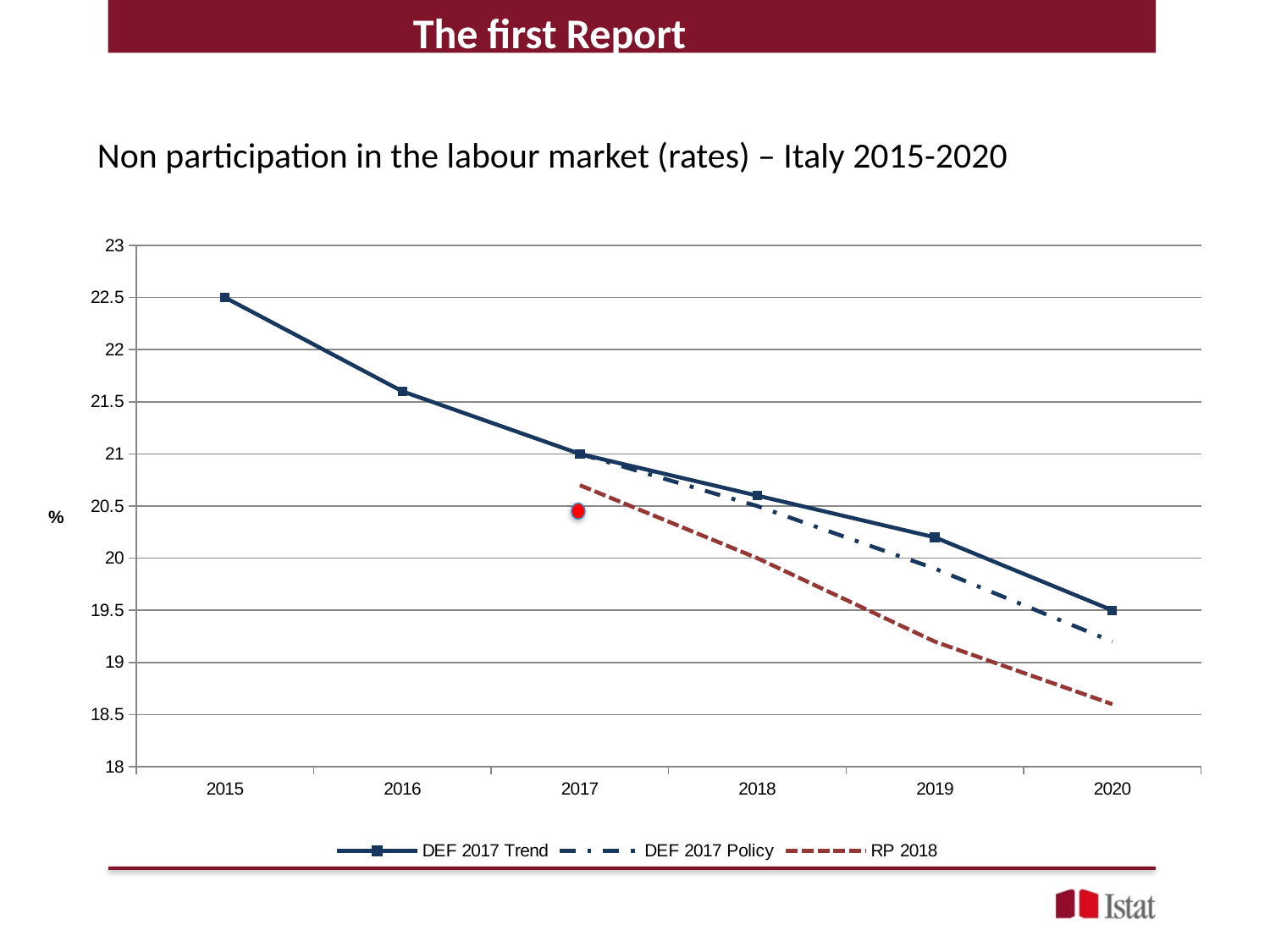
What is the difference between the DEF 2017 Trend values in 2015 and 2020? 3 Is the value for RP 2018 in 2020 greater or less than 19? less How many years are shown on the x axis? 6 What is the value of DEF 2017 Trend in 2020? 19.5 What kind of chart is shown on the slide? line chart In 2020, which series has the higher value, DEF 2017 Trend or RP 2018? DEF 2017 Trend In which year is the DEF 2017 Trend value highest? 2015 How many series does the legend list? 3 Do the DEF 2017 Trend values rise or fall from 2015 to 2020? fall Is the value for DEF 2017 Trend in 2016 greater or less than 22? less What is the value of DEF 2017 Trend in 2015? 22.5 What is the value of DEF 2017 Trend in 2017? 21